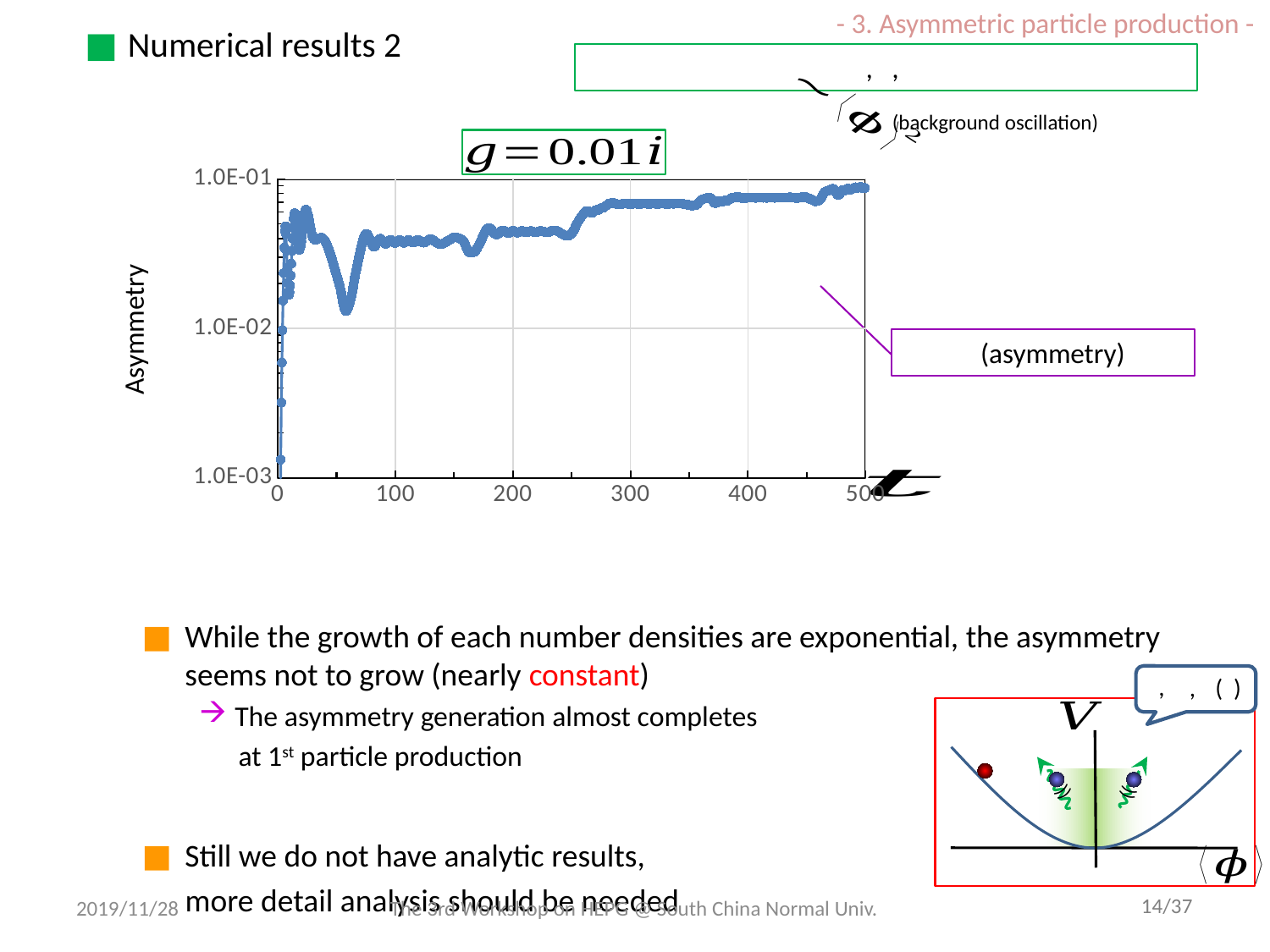
Is the asymmetry value at t = 400 greater or less than 1.0E-01? less Is the asymmetry value at t = 500 greater or less than 1.0E-02? greater What is the label of the vertical axis of the chart? Asymmetry What kind of chart is shown on the slide? scatter chart Is the asymmetry value at t = 100 greater or less than 1.0E-01? less What is the largest tick value shown on the horizontal axis of the chart? 500 Does the asymmetry overall rise or fall as t increases from 100 to 500? rise How many data series are plotted in the chart? 1 What is the lowest tick value shown on the vertical axis of the chart? 1.0E-03 What is the title printed above the chart? g = 0.01i Is the asymmetry at t = 500 larger or smaller than the asymmetry at t = 100? larger